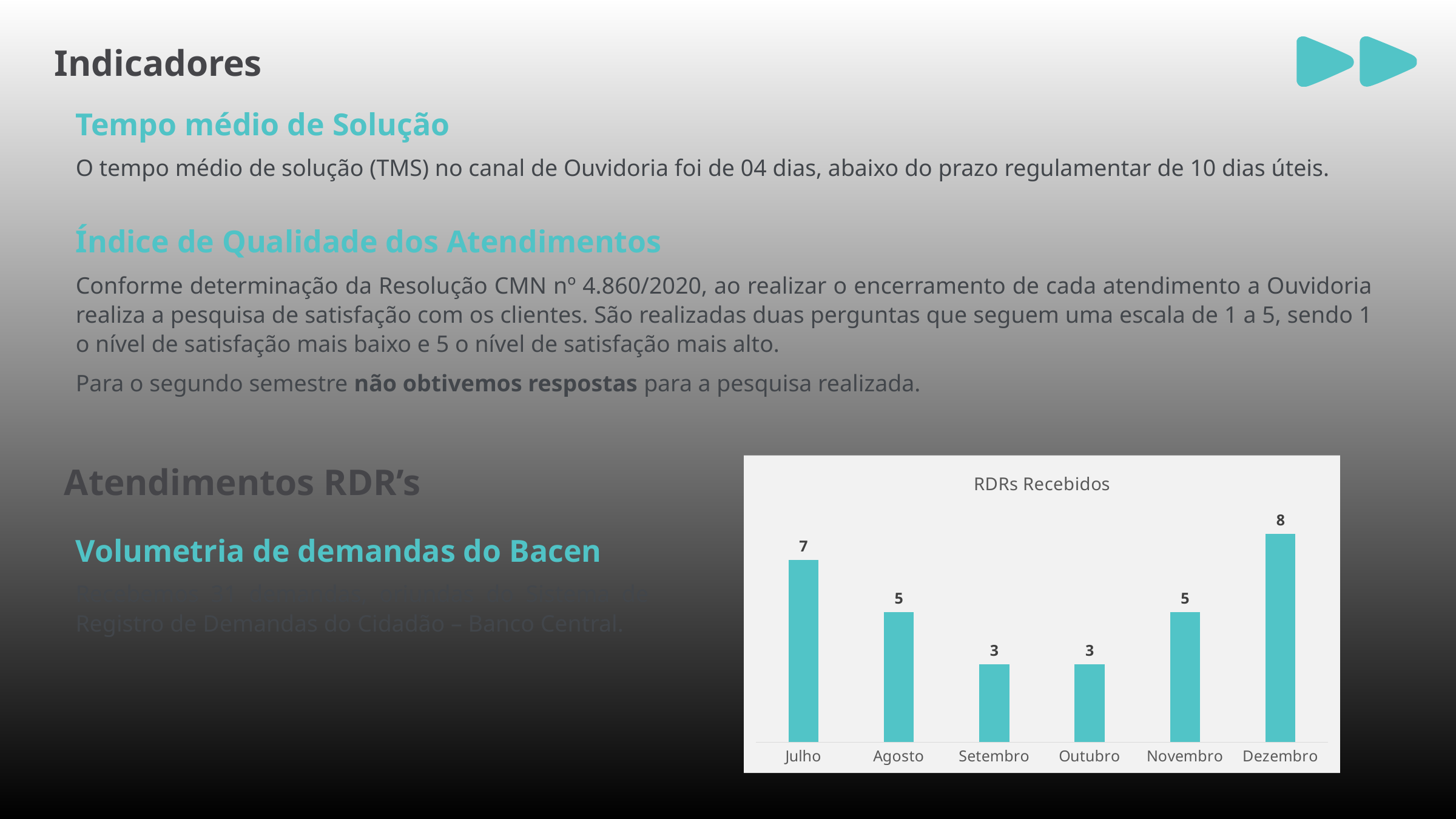
Which month has the highest value in the RDRs Recebidos chart? Dezembro How many months are shown in the RDRs Recebidos chart? 6 What kind of chart is the RDRs Recebidos chart? Bar chart What is the difference between the values for Dezembro and Julho in the RDRs Recebidos chart? 1 What is the difference between the values for Julho and Agosto in the RDRs Recebidos chart? 2 What is the value for Dezembro in the RDRs Recebidos chart? 8 What is the value for Julho in the RDRs Recebidos chart? 7 Which is larger in the RDRs Recebidos chart, the value for Agosto or the value for Outubro? Agosto What is the title of the chart on the slide? RDRs Recebidos What is the value for Setembro in the RDRs Recebidos chart? 3 Which months share the lowest value in the RDRs Recebidos chart? Setembro and Outubro What is the total of all the values shown in the RDRs Recebidos chart? 31